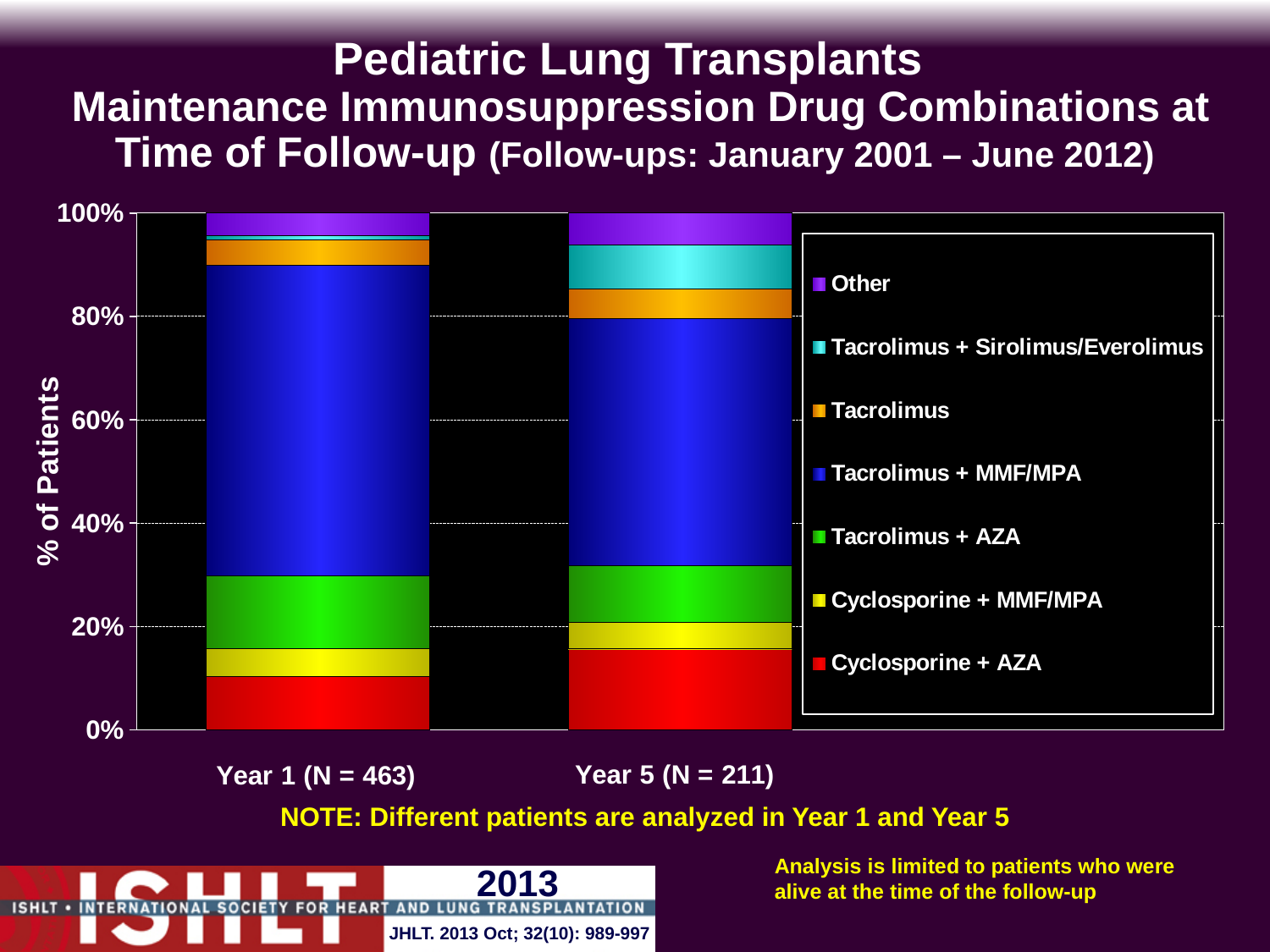
Is the share of Cyclosporine + AZA in Year 5 greater or less than 20%? less Is the share of Tacrolimus + MMF/MPA in Year 1 greater or less than 40%? greater What kind of chart is shown on the slide? Stacked bar chart Is the share of Tacrolimus + MMF/MPA larger in Year 1 or Year 5? Year 1 What is the number of patients (N) for the Year 1 bar? 463 Which drug combination makes up the largest segment of the Year 1 bar? Tacrolimus + MMF/MPA How many bars (follow-up time points) are plotted in the chart? 2 Which drug combination makes up the smallest segment of the Year 1 bar? Tacrolimus + Sirolimus/Everolimus How many drug combination series does the legend list? 7 Is the share of Tacrolimus + Sirolimus/Everolimus larger in Year 1 or Year 5? Year 5 Does the share of Tacrolimus + MMF/MPA rise or fall from Year 1 to Year 5? fall Which drug combination makes up the largest segment of the Year 5 bar? Tacrolimus + MMF/MPA